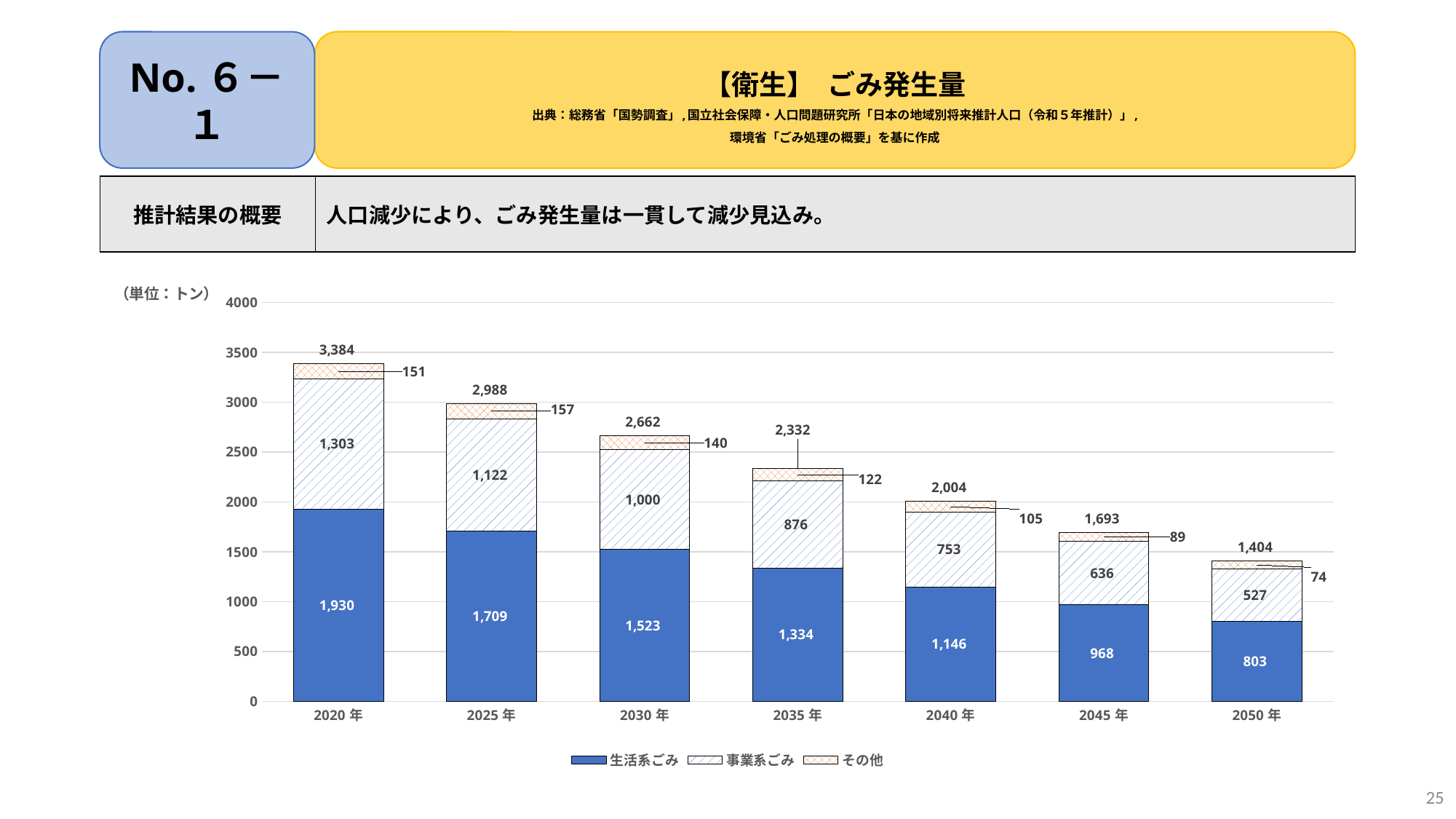
How many series does the legend list? 3 Which is larger, the 事業系ごみ value for 2040年 or the 事業系ごみ value for 2045年? 2040年 Which year has the highest total ごみ発生量? 2020年 Do the total values rise or fall from 2020年 to 2050年? Fall What is the value of 生活系ごみ for 2020年? 1,930 What is the value of 事業系ごみ for 2035年? 876 What is the value of その他 for 2050年? 74 What is the difference between the 生活系ごみ values for 2020年 and 2025年? 221 What kind of chart is shown on the slide? Stacked bar chart Which year has the lowest value for 生活系ごみ? 2050年 What is the total of the stacked bar for 2030年? 2,662 How many years are shown on the x axis? 7